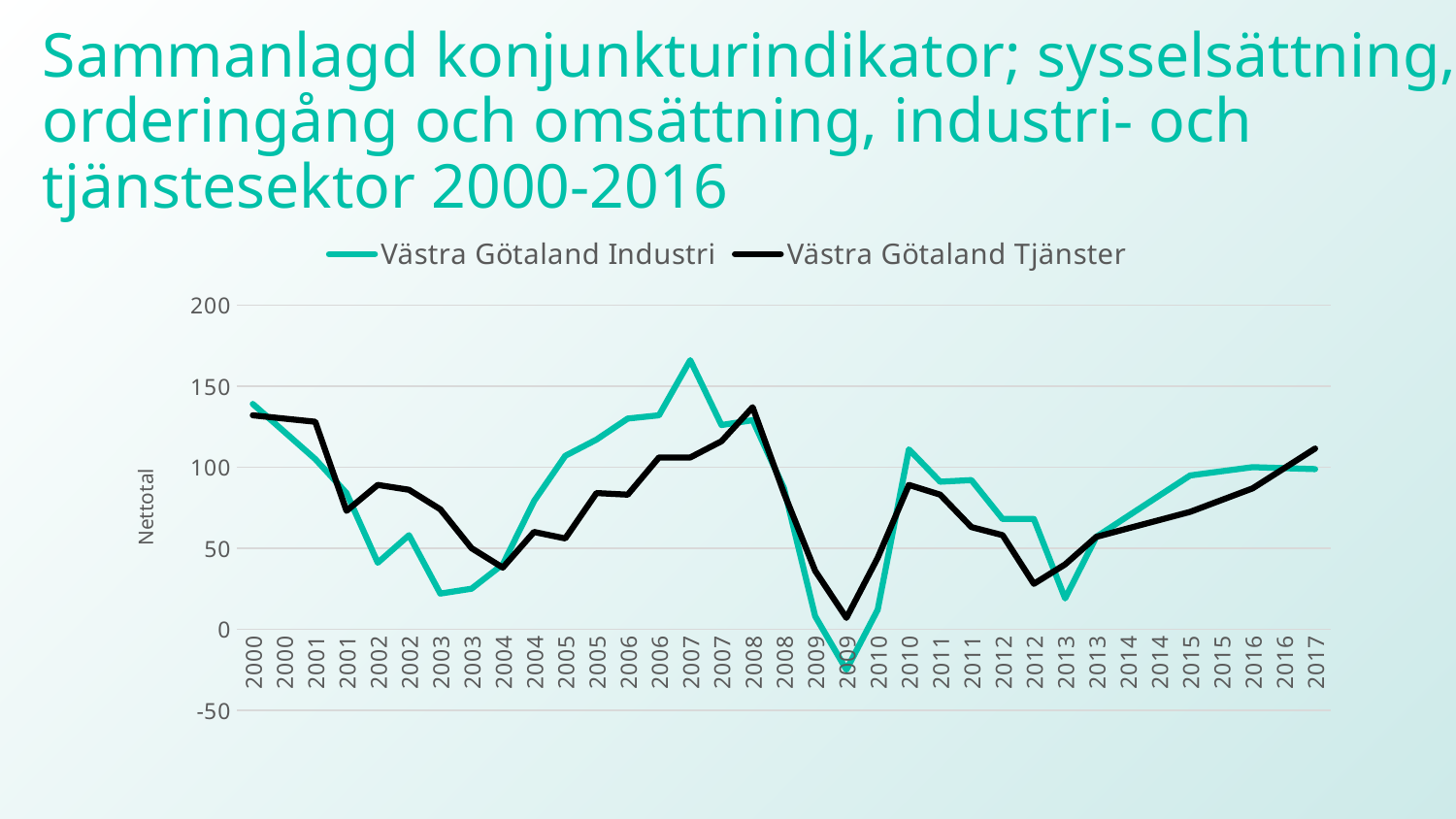
In which year does the Västra Götaland Tjänster line reach its lowest point? 2009 How many series does the legend list? 2 Is the lowest value of Västra Götaland Industri in 2009 greater or less than 0? less In which year does the Västra Götaland Industri line reach its highest point? 2007 What are the two series named in the legend? Västra Götaland Industri and Västra Götaland Tjänster Is the value for Västra Götaland Tjänster in 2017 greater or less than 100? greater What is the label on the vertical axis? Nettotal Is the peak value of Västra Götaland Industri in 2007 greater or less than 150? greater What kind of chart is shown on the slide? line chart In which year does the Västra Götaland Industri line reach its lowest point? 2009 Do both lines rise or fall between 2008 and 2009? fall At the 2007 peak, which series has the higher value, Västra Götaland Industri or Västra Götaland Tjänster? Västra Götaland Industri